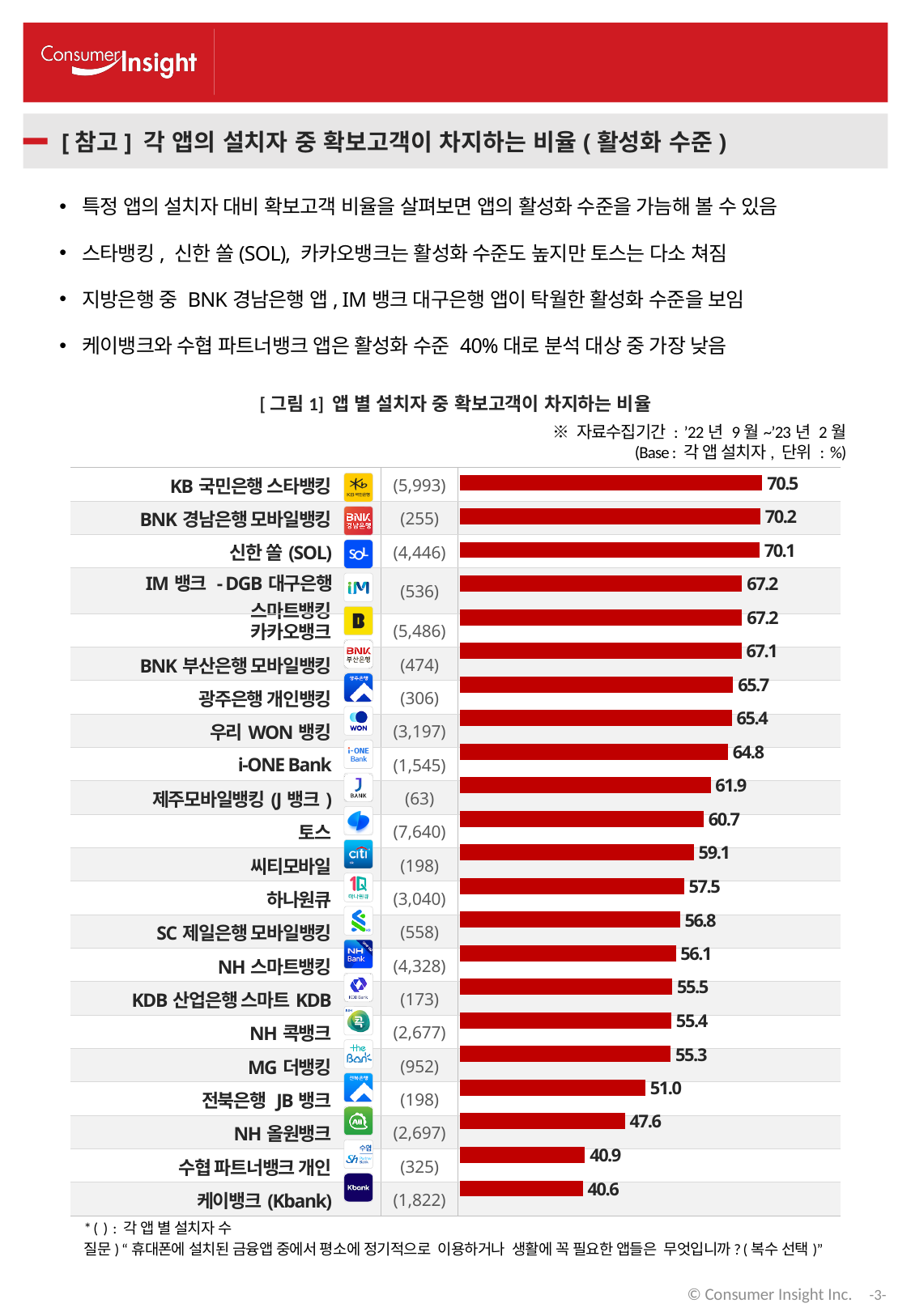
What is the data collection period stated above the chart? '22년 9월 ~'23년 2월 What type of chart is shown in [그림 1]? bar chart What is the value for NH 올원뱅크 in the chart? 47.6 What is the value for 카카오뱅크 in the chart? 67.2 How many apps are shown in the chart? 22 Which has a larger value, 우리 WON 뱅킹 or 씨티모바일? 우리 WON 뱅킹 What is the value for 토스 in the chart? 60.7 What is the difference between the values for 토스 and 하나원큐? 3.2 Which app has the lowest value in the chart? 케이뱅크 (Kbank) What is the difference between the values for KB 국민은행 스타뱅킹 and 케이뱅크 (Kbank)? 29.9 Which app has the highest value in the chart? KB 국민은행 스타뱅킹 What is the number of installers shown in parentheses for 토스? (7,640)